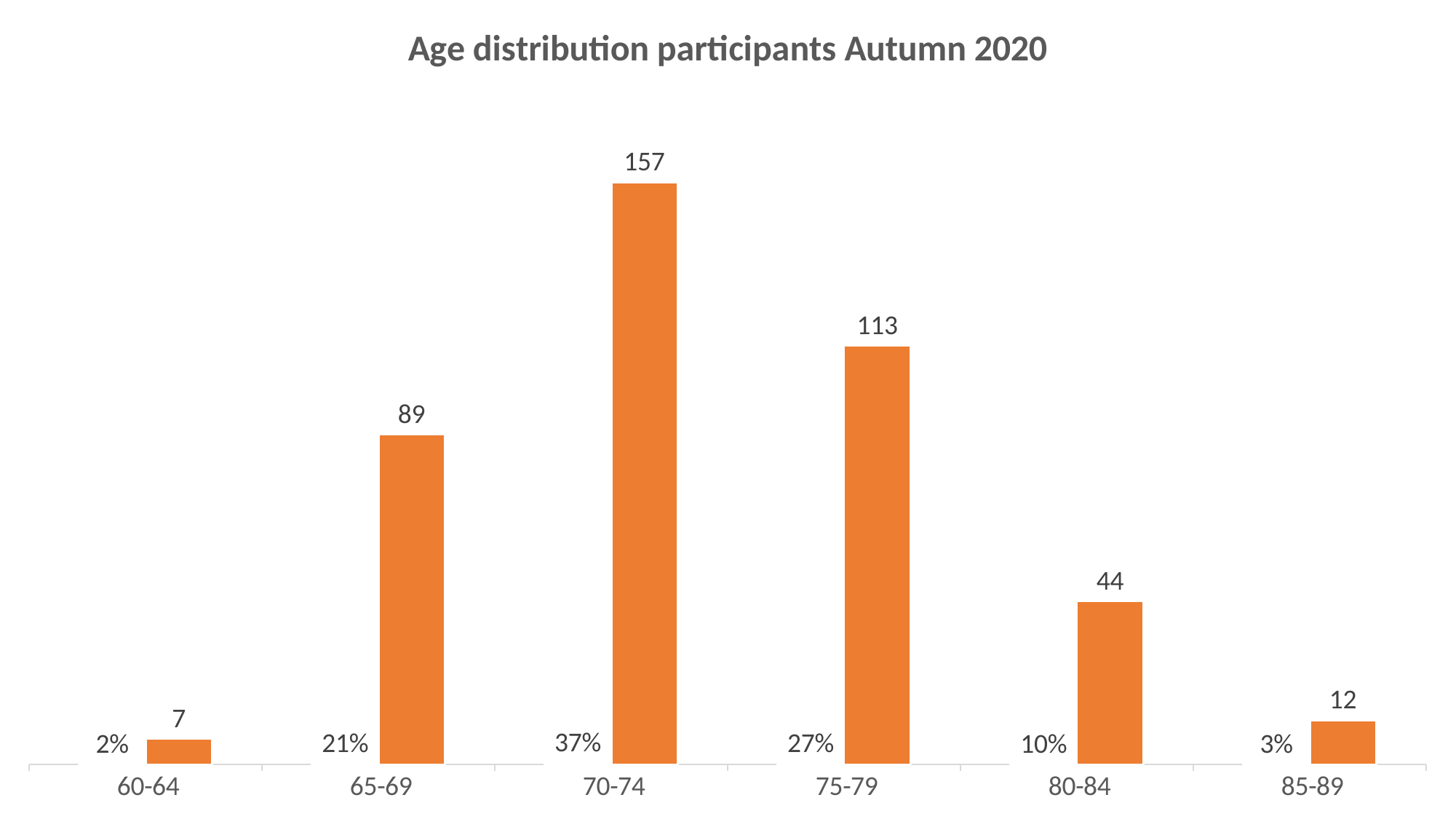
What is the number of participants in the 70-74 age group? 157 What is the title of the chart? Age distribution participants Autumn 2020 How many age groups are shown in the chart? 6 What percentage of participants are in the 85-89 age group? 3% What is the number of participants in the 80-84 age group? 44 Which age group has the lowest number of participants? 60-64 What kind of chart is shown on the slide? Bar chart Which age group has more participants, 65-69 or 75-79? 75-79 What percentage of participants are in the 65-69 age group? 21% Which age group has the highest number of participants? 70-74 What is the difference in participants between the 70-74 and 75-79 age groups? 44 Do the participant numbers rise or fall from the 70-74 age group to the 85-89 age group? Fall